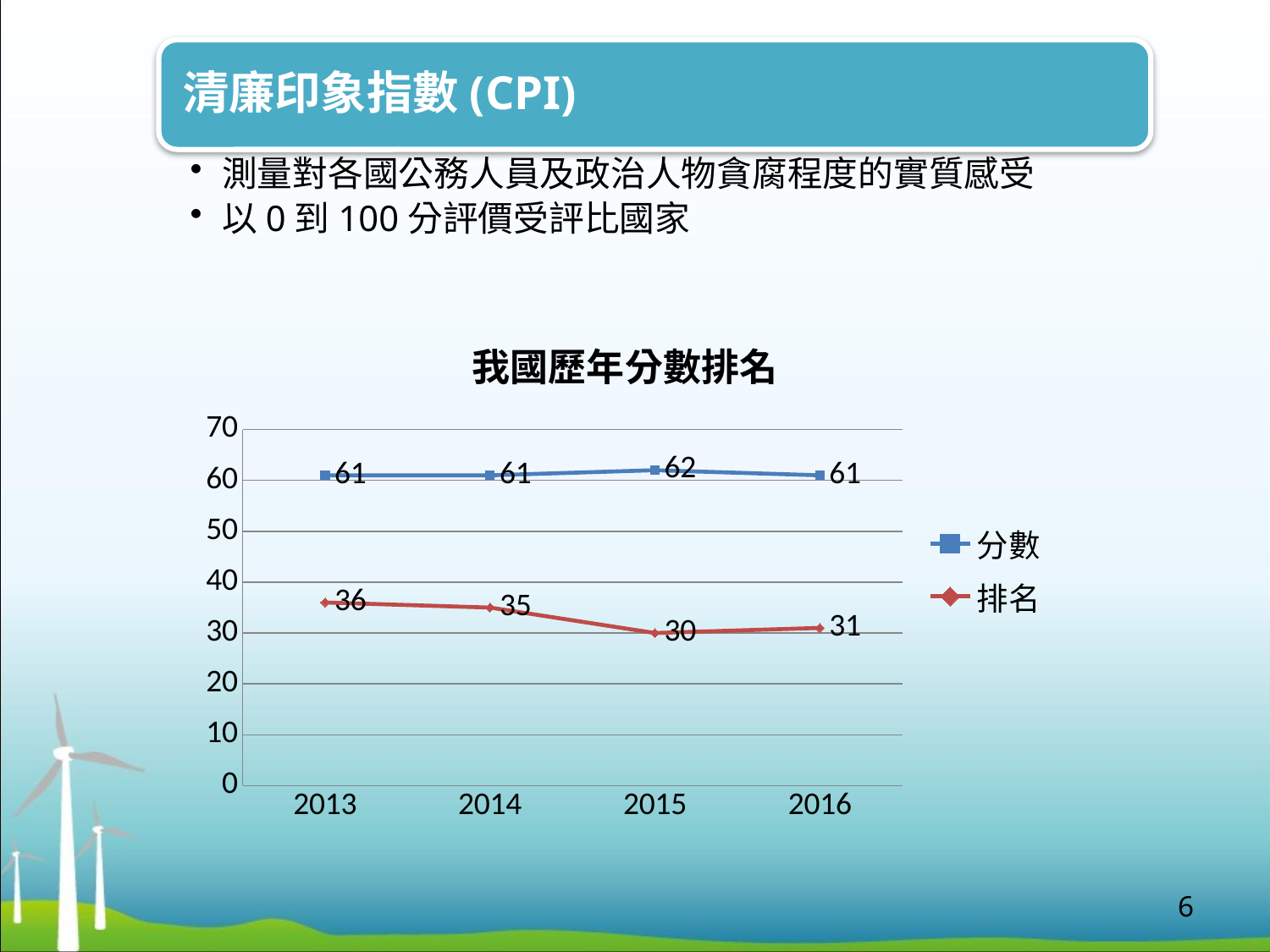
What is the title of the chart? 我國歷年分數排名 What is the 排名 value for 2013? 36 What is the 排名 value for 2016? 31 Does the 排名 series rise or fall from 2013 to 2015? fall What type of chart is shown on the slide? line chart How many years are shown on the x axis? 4 What is the difference between the 分數 value and the 排名 value in 2014? 26 What is the 分數 value for 2015? 62 Which is larger, the 排名 value for 2013 or for 2016? 2013 How many series does the legend list? 2 In which year is the 排名 series lowest? 2015 In which year is the 分數 series highest? 2015